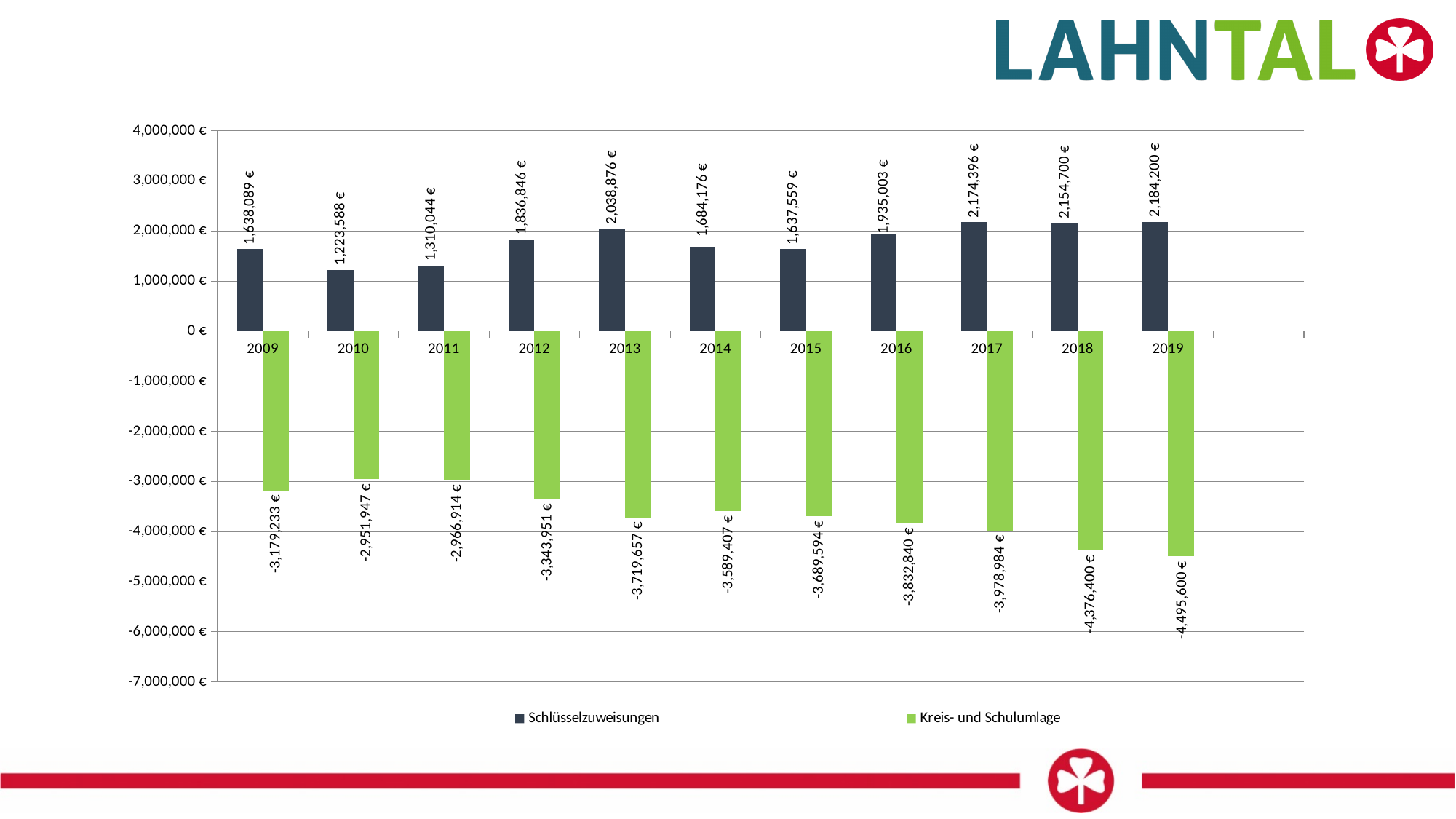
In which year are the Schlüsselzuweisungen highest? 2019 Which series is shown in green in the legend? Kreis- und Schulumlage What is the value of Schlüsselzuweisungen for 2010? 1,223,588 € In which year are the Schlüsselzuweisungen lowest? 2010 How many years are shown on the x axis? 11 What is the value of Kreis- und Schulumlage for 2016? -3,832,840 € How many series does the legend list? 2 What is the value of Schlüsselzuweisungen for 2013? 2,038,876 € In which year is the Kreis- und Schulumlage most negative (largest in magnitude)? 2019 By how much did the Schlüsselzuweisungen in 2019 exceed those in 2009? 546,111 € Which year has the larger Schlüsselzuweisungen, 2012 or 2014? 2012 What kind of chart is shown on the slide? Bar chart